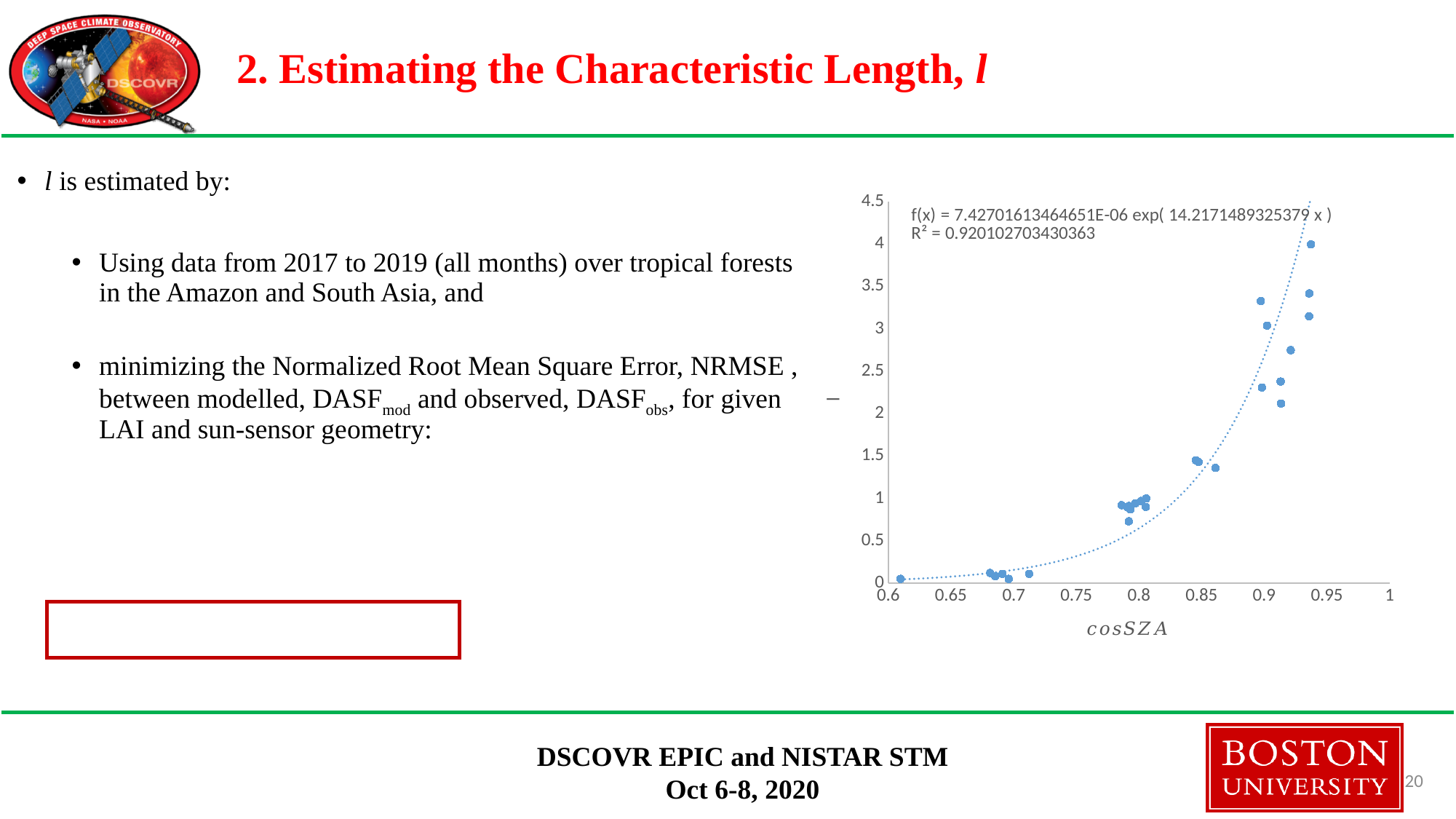
What is the label of the x axis of the chart? cosSZA Do the plotted values generally rise or fall as cosSZA increases? rise Is the value of the point plotted near cosSZA = 0.9 at the top of that cluster greater or less than 3? greater Is the value of the point plotted near cosSZA = 0.61 greater or less than 0.5? less What kind of chart is shown on the slide? scatter chart Which has the larger value: the point plotted near cosSZA = 0.94 at the top of the chart or the point plotted near cosSZA = 0.71? the point near cosSZA = 0.94 What is the maximum value shown on the y axis of the chart? 4.5 Are the values of the points plotted near cosSZA = 0.8 greater or less than 1.5? less What R² value is printed on the chart? R² = 0.920102703430363